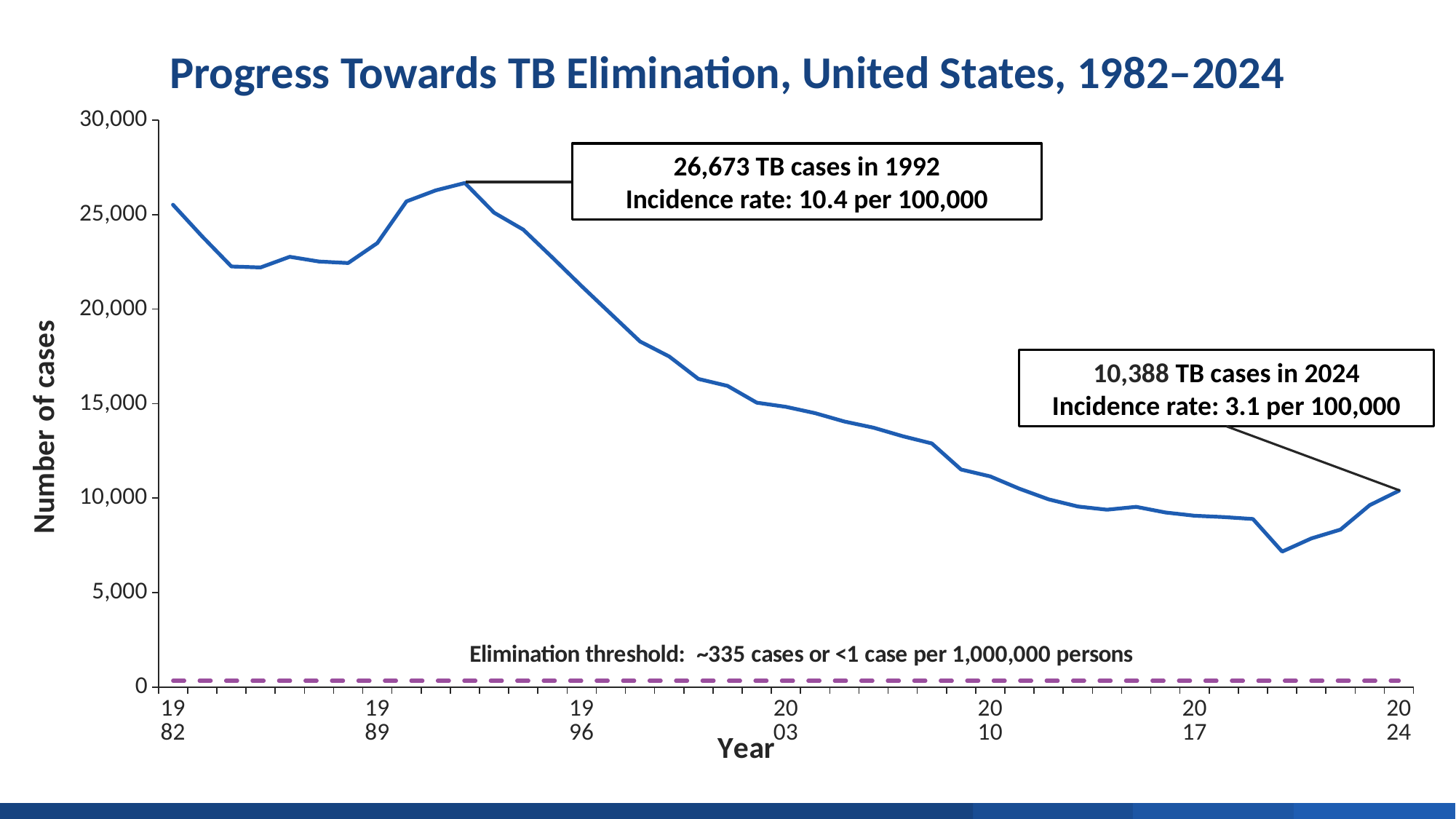
What is the difference in the number of TB cases between 1992 and 2024? 16,285 What was the TB incidence rate in 1992? 10.4 per 100,000 What was the TB incidence rate in 2024? 3.1 per 100,000 Is the number of cases in 2010 greater or less than 10,000? greater What is the elimination threshold stated on the chart? ~335 cases or <1 case per 1,000,000 persons Which year had more TB cases, 1992 or 2024? 1992 What type of chart is shown on the slide? line chart How many TB cases were reported in 1992 according to the annotation? 26,673 How many TB cases were reported in 2024 according to the annotation? 10,388 Does the number of TB cases rise or fall between 1992 and 2017? fall Is the number of cases in 2017 greater or less than 10,000? less In which year does the number of TB cases reach its peak? 1992